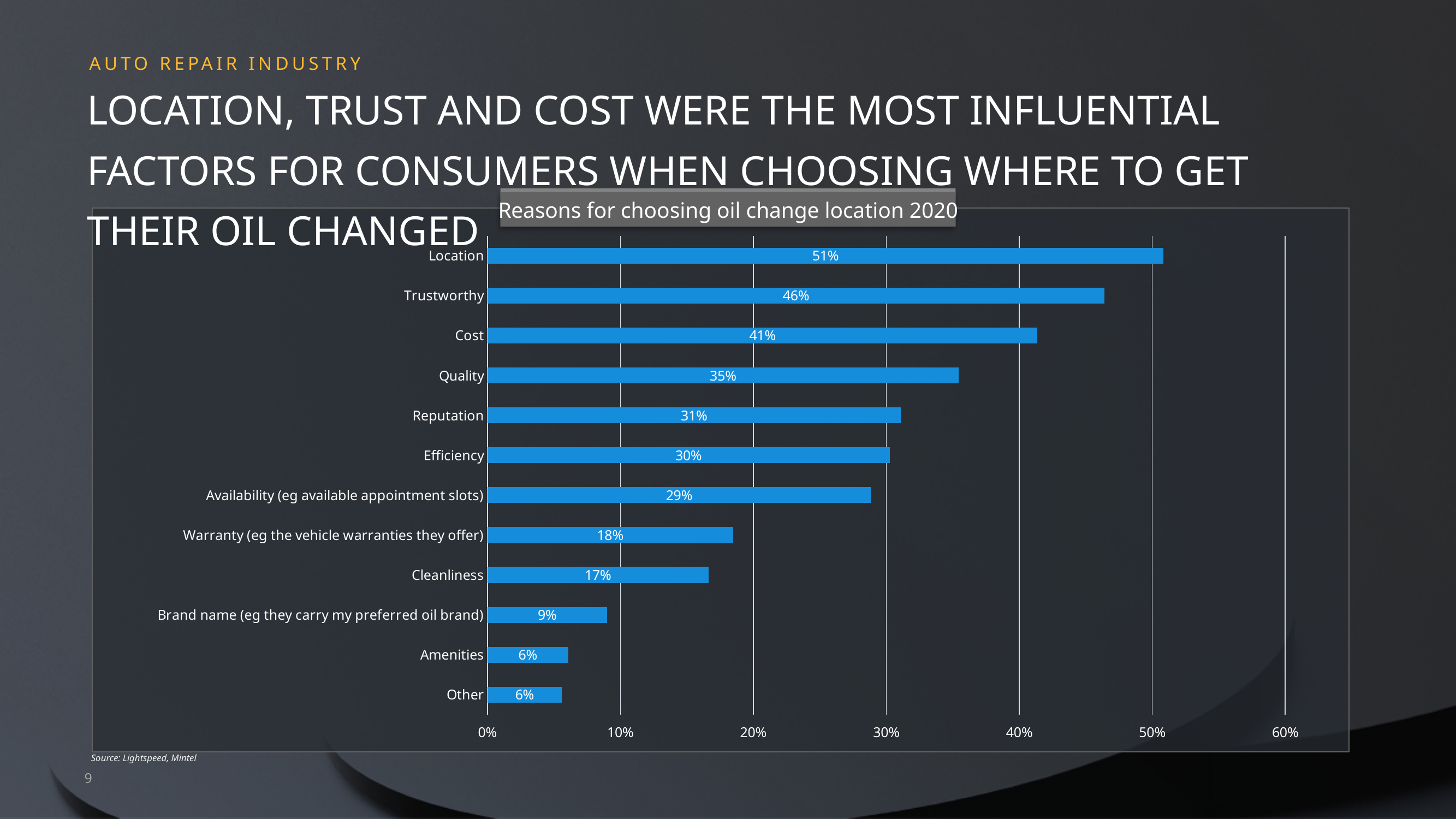
What is the value for Brand name (eg they carry my preferred oil brand)? 9% What is the difference between the values for Location and Cost? 10% Is the value for Availability (eg available appointment slots) greater or less than 30%? less What kind of chart is shown on the slide? Bar chart Which reason has the highest percentage? Location What is the value for Warranty (eg the vehicle warranties they offer)? 18% Which is larger, the value for Reputation or the value for Efficiency? Reputation How many reasons are listed in the chart? 12 What percentage of consumers chose Location as a reason for choosing their oil change location? 51% What is the value for Trustworthy? 46% What is the difference between the values for Quality and Cleanliness? 18% What is the title of the chart? Reasons for choosing oil change location 2020